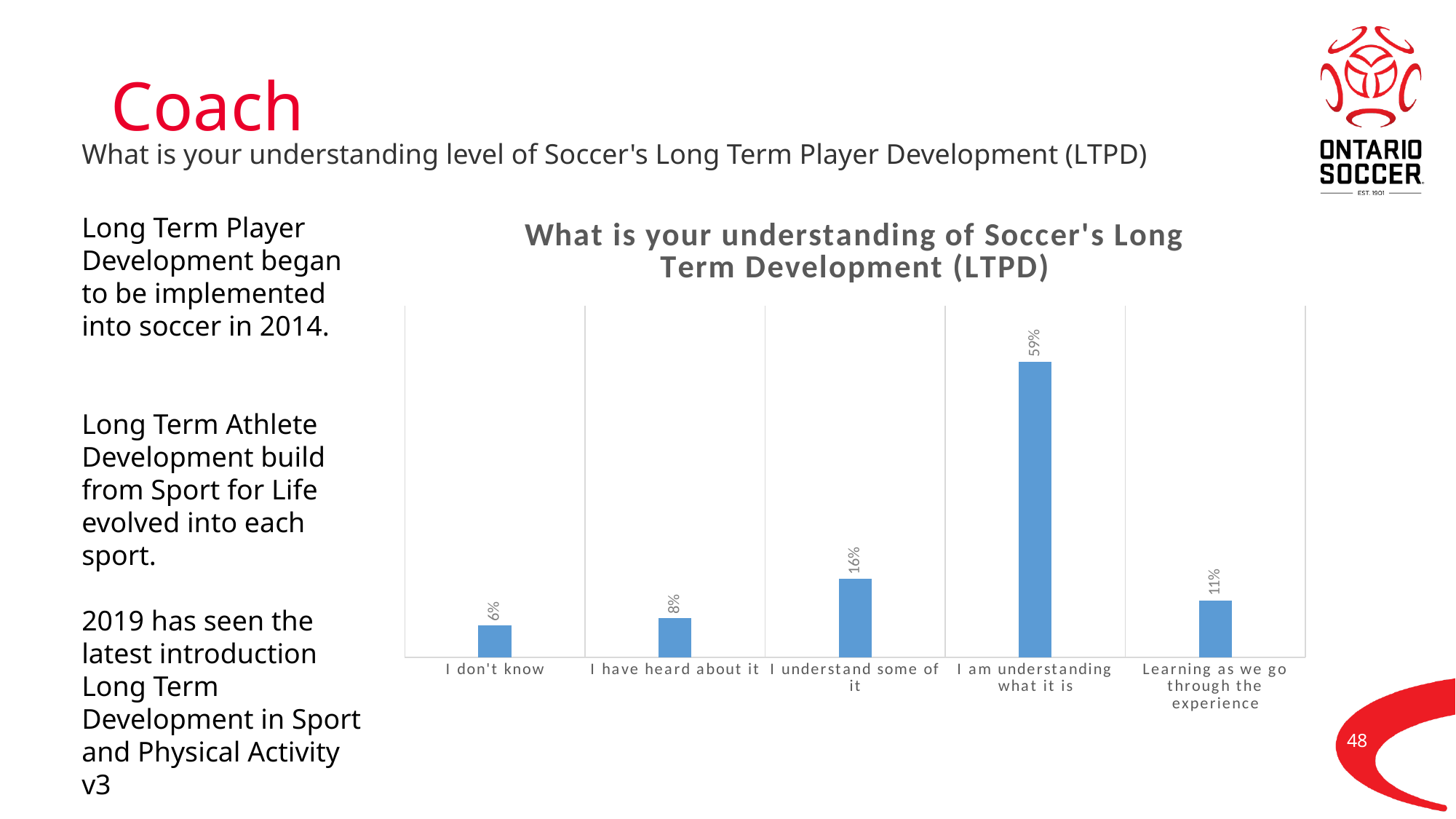
Which category has the lowest value? I don't know What is the value for "Learning as we go through the experience"? 11% What is the value for "I don't know"? 6% Which category has the highest value? I am understanding what it is What is the value for "I have heard about it"? 8% What is the difference between "Learning as we go through the experience" and "I have heard about it"? 3% What kind of chart is shown on the slide? Bar chart What is the difference between "I am understanding what it is" and "I understand some of it"? 43% How many categories are shown on the x axis? 5 What is the title of the chart? What is your understanding of Soccer's Long Term Development (LTPD) Which is larger: "I understand some of it" or "Learning as we go through the experience"? I understand some of it What percentage of coaches answered "I am understanding what it is"? 59%